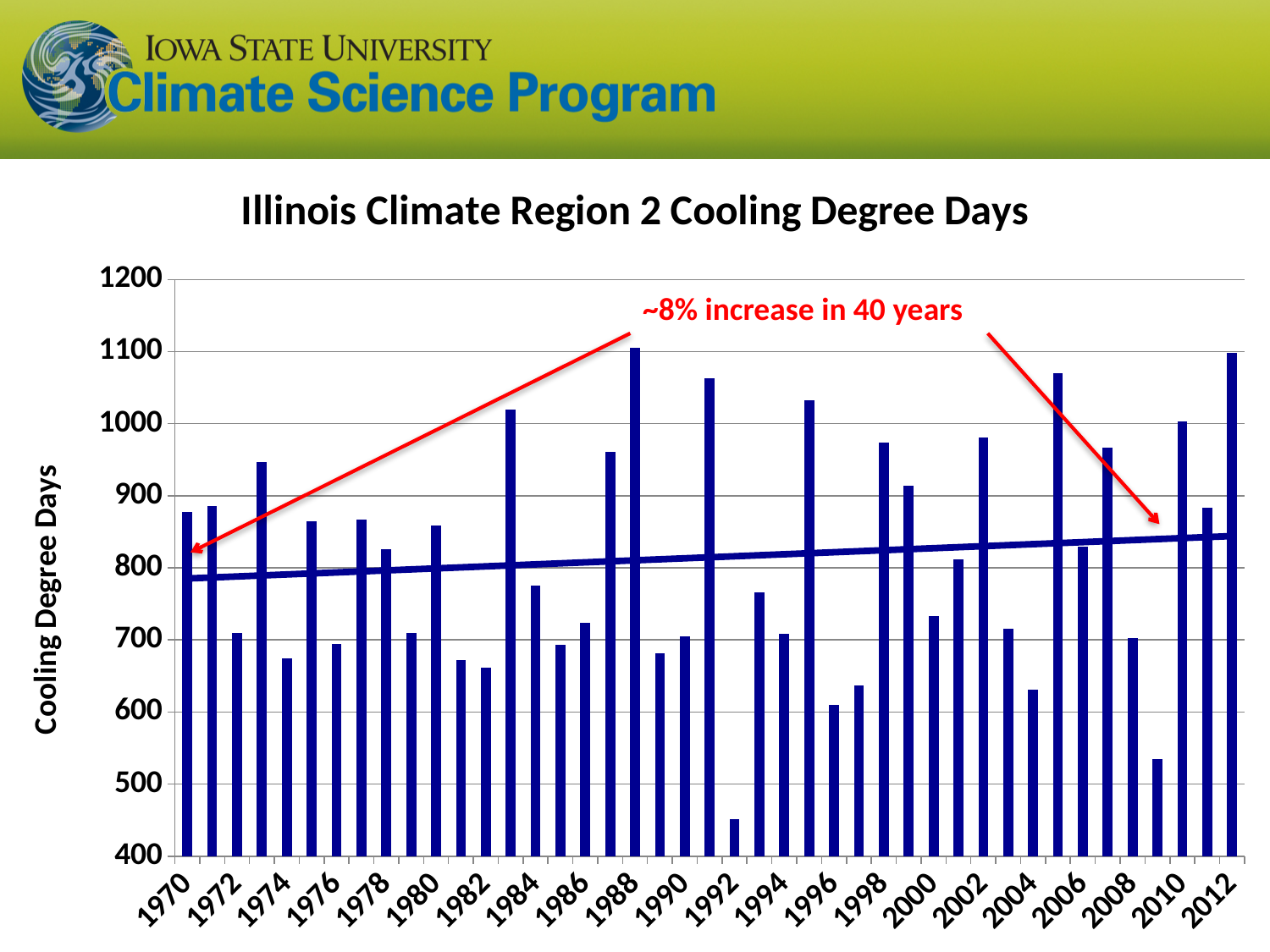
What is the title of the chart? Illinois Climate Region 2 Cooling Degree Days Which year has the larger value, 1983 or 1984? 1983 What is the label on the vertical axis of the chart? Cooling Degree Days What kind of chart is shown on the slide? bar chart Is the value for 2009 greater or less than 600? less Is the value for 1973 greater or less than 900? greater Is the value for 1992 greater or less than 500? less Which year has the larger value, 1992 or 1993? 1993 Does the trend line in the chart rise or fall from 1970 to 2012? rise Which year has the lowest cooling degree days value in the chart? 1992